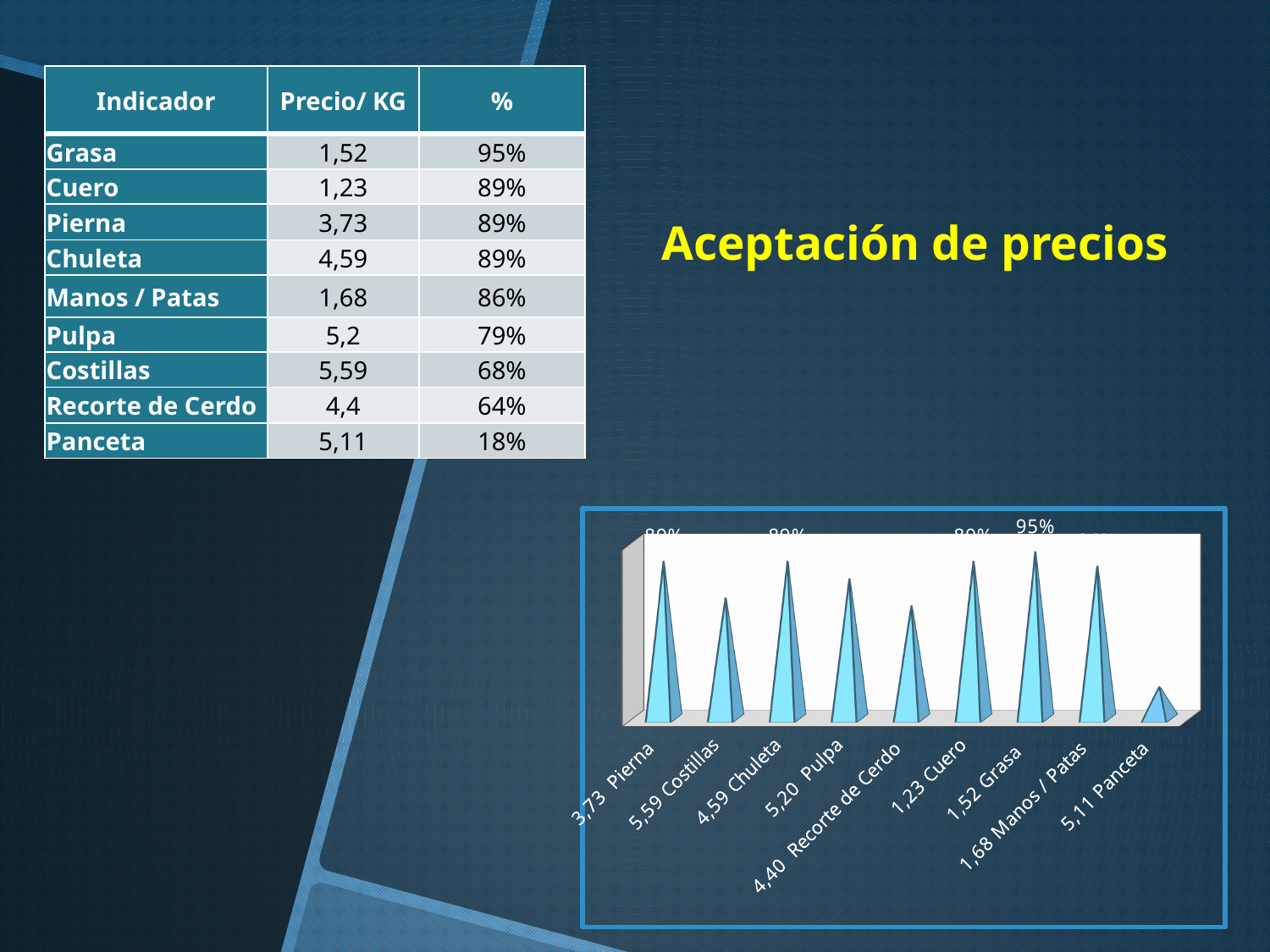
Which category has the highest value in the chart? 1,52 Grasa What is the difference between the percentage for Grasa and the percentage for Panceta shown on the slide? 77% What is the value shown for Grasa in the chart? 95% What kind of chart is shown at the bottom right of the slide? bar chart What title is displayed next to the chart? Aceptación de precios In the chart, which is larger: the value for Cuero or the value for Panceta? Cuero In the chart, which is larger: the value for Pulpa or the value for Recorte de Cerdo? Pulpa In the chart, which is larger: the value for Pierna or the value for Costillas? Pierna How many categories are plotted in the chart? 9 What is the first category label on the chart's x axis? 3,73 Pierna Which category has the lowest value in the chart? 5,11 Panceta